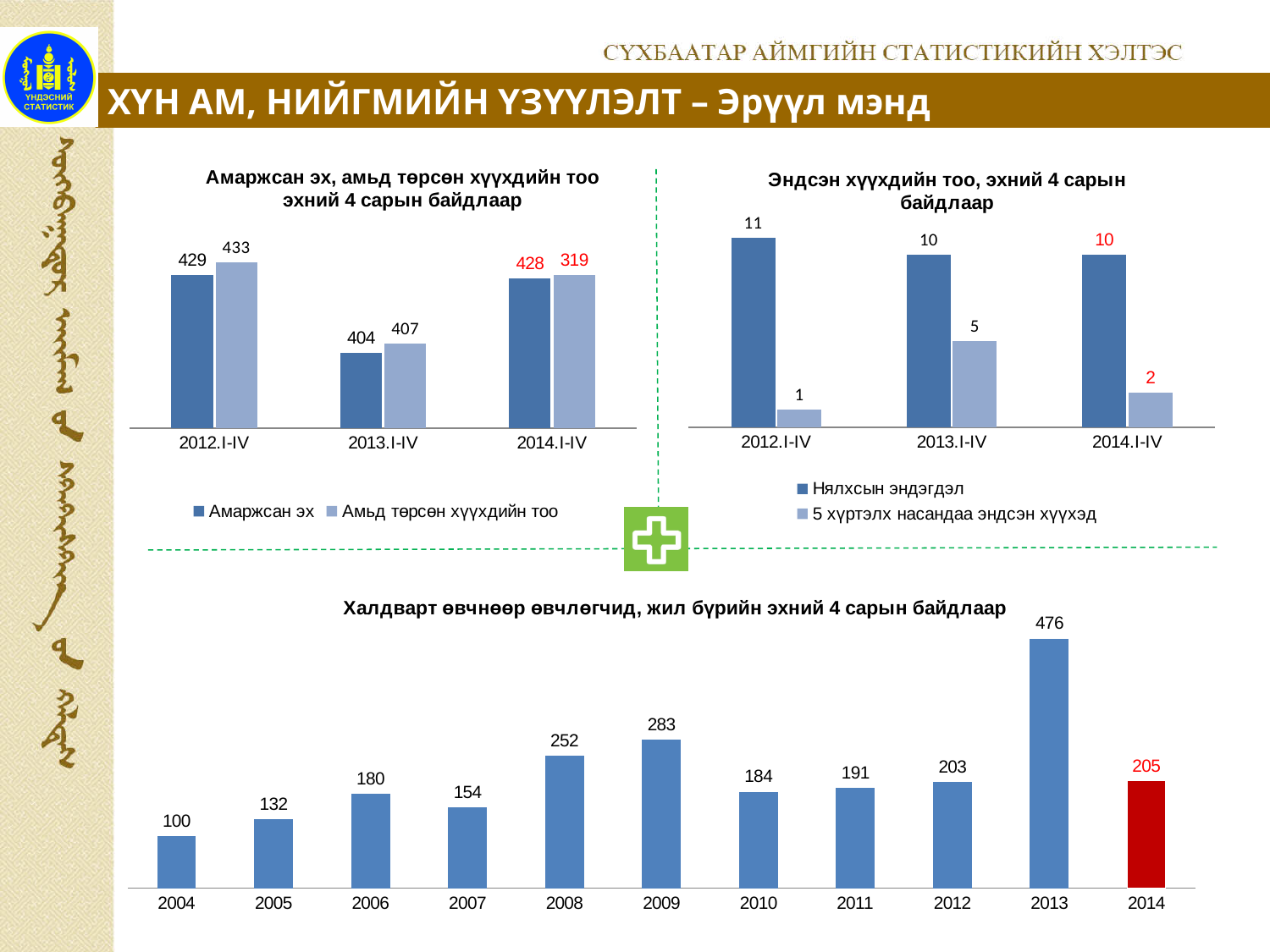
In the top-right chart 'Эндсэн хүүхдийн тоо, эхний 4 сарын байдлаар', in which period is '5 хүртэлх насандаа эндсэн хүүхэд' highest? 2013.I-IV In the top-left chart 'Амаржсан эх, амьд төрсөн хүүхдийн тоо эхний 4 сарын байдлаар', what is the difference between 'Амаржсан эх' and 'Амьд төрсөн хүүхдийн тоо' for 2013.I-IV? 3 In the top-left chart 'Амаржсан эх, амьд төрсөн хүүхдийн тоо эхний 4 сарын байдлаар', what is the value of 'Амьд төрсөн хүүхдийн тоо' for 2014.I-IV? 319 In the bottom chart 'Халдварт өвчнөөр өвчлөгчид, жил бүрийн эхний 4 сарын байдлаар', what is the difference between the values for 2013 and 2014? 271 In the bottom chart 'Халдварт өвчнөөр өвчлөгчид, жил бүрийн эхний 4 сарын байдлаар', which is larger, the value for 2008 or the value for 2009? 2009 In the bottom chart 'Халдварт өвчнөөр өвчлөгчид, жил бүрийн эхний 4 сарын байдлаар', what is the value for 2013? 476 In the top-right chart 'Эндсэн хүүхдийн тоо, эхний 4 сарын байдлаар', what is the value of 'Нялхсын эндэгдэл' for 2012.I-IV? 11 In the top-left chart 'Амаржсан эх, амьд төрсөн хүүхдийн тоо эхний 4 сарын байдлаар', how many series does the legend list? 2 In the bottom chart 'Халдварт өвчнөөр өвчлөгчид, жил бүрийн эхний 4 сарын байдлаар', how many years are shown on the x axis? 11 In the bottom chart 'Халдварт өвчнөөр өвчлөгчид, жил бүрийн эхний 4 сарын байдлаар', which bar is coloured red? 2014 What kind of chart is the top-right chart 'Эндсэн хүүхдийн тоо, эхний 4 сарын байдлаар'? Bar chart In the bottom chart 'Халдварт өвчнөөр өвчлөгчид, жил бүрийн эхний 4 сарын байдлаар', which year has the lowest value? 2004